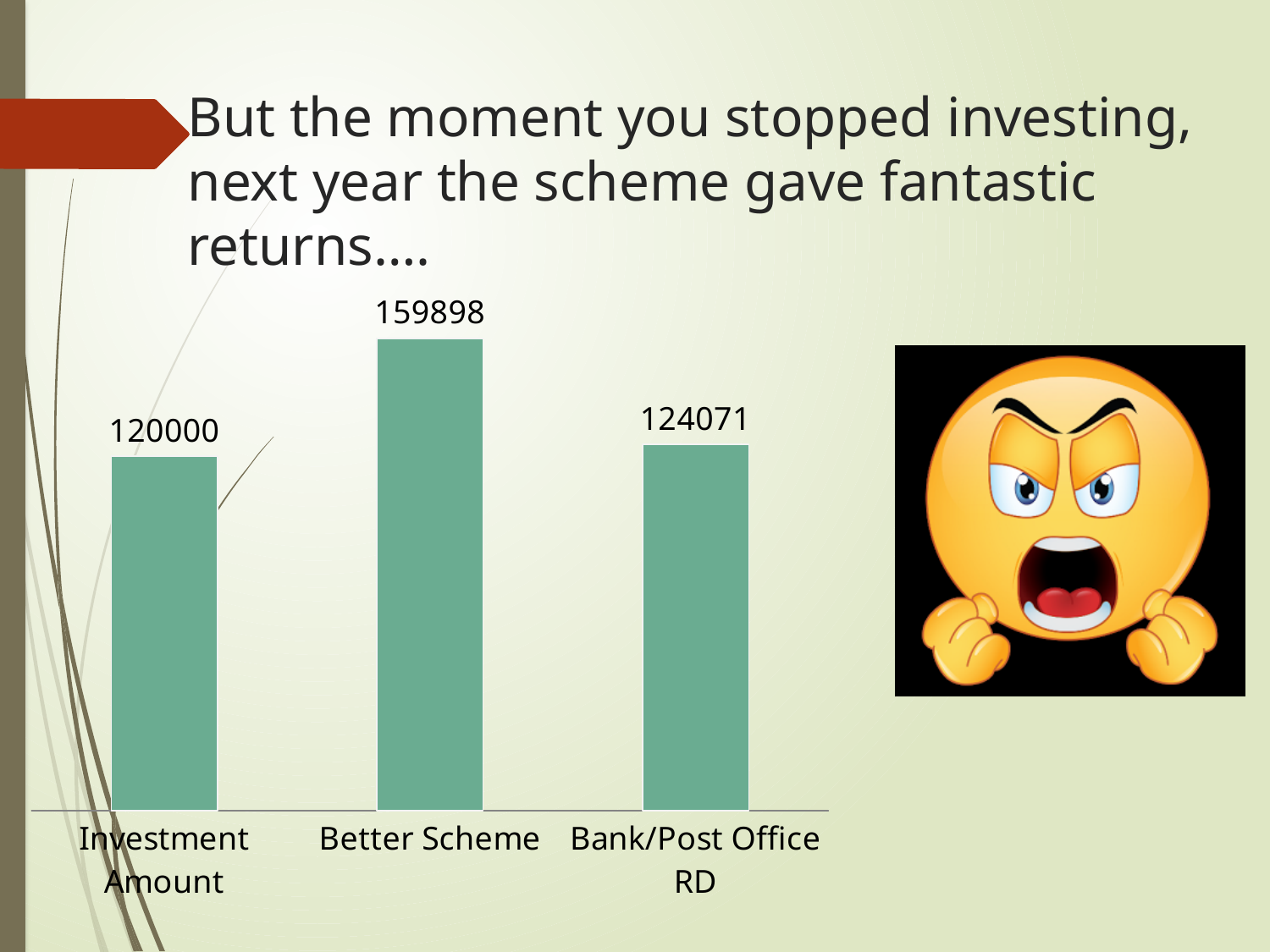
What kind of chart is shown on the slide? Bar chart Which is larger, the value for Better Scheme or the value for Bank/Post Office RD? Better Scheme Which category has the lowest value? Investment Amount What is the difference between the Better Scheme value and the Bank/Post Office RD value? 35827 What colour are the bars in the chart? Green What is the value for Investment Amount? 120000 What is the difference between the Better Scheme value and the Investment Amount value? 39898 How many categories are shown in the chart? 3 What is the difference between the Bank/Post Office RD value and the Investment Amount value? 4071 What is the value for Bank/Post Office RD? 124071 Which category has the highest value? Better Scheme What is the value for Better Scheme? 159898